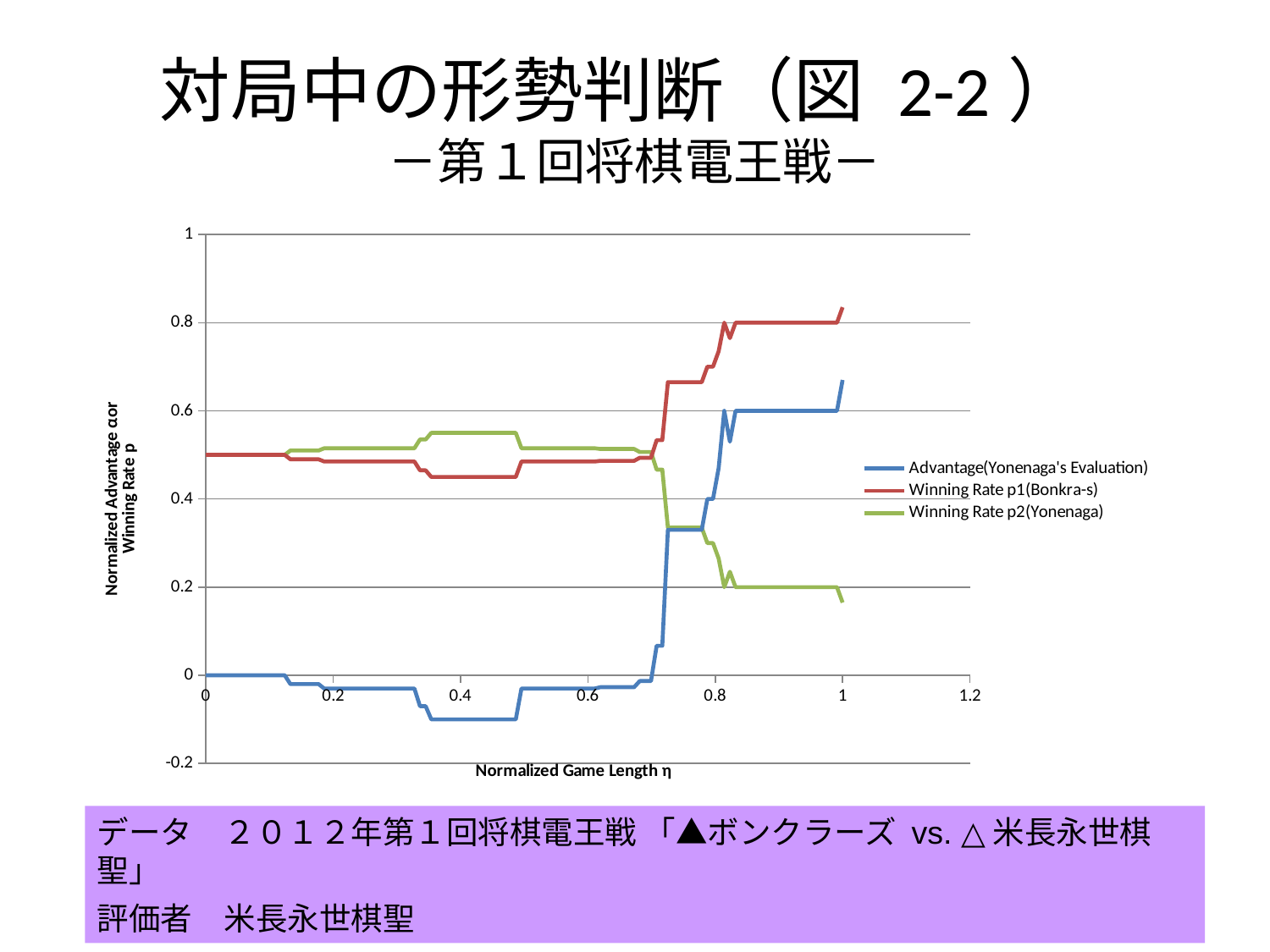
Is the value of Winning Rate p2(Yonenaga) at Normalized Game Length 0.9 greater or less than 0.4? less Is the value of Advantage(Yonenaga's Evaluation) at Normalized Game Length 0.9 greater or less than 0.4? greater How many series does the legend list? 3 Is the value of Winning Rate p1(Bonkra-s) at Normalized Game Length 0.9 greater or less than 0.6? greater At Normalized Game Length 0.9, which is higher: Winning Rate p1(Bonkra-s) or Winning Rate p2(Yonenaga)? Winning Rate p1(Bonkra-s) Which series is drawn in red according to the legend? Winning Rate p1(Bonkra-s) What kind of chart is shown on the slide? line chart What is the value of Advantage(Yonenaga's Evaluation) at Normalized Game Length 0? 0 Does Winning Rate p2(Yonenaga) overall rise or fall as Normalized Game Length increases from 0.7 to 1? fall Does Winning Rate p1(Bonkra-s) overall rise or fall as Normalized Game Length increases from 0.7 to 1? rise What is the title of the x axis? Normalized Game Length η